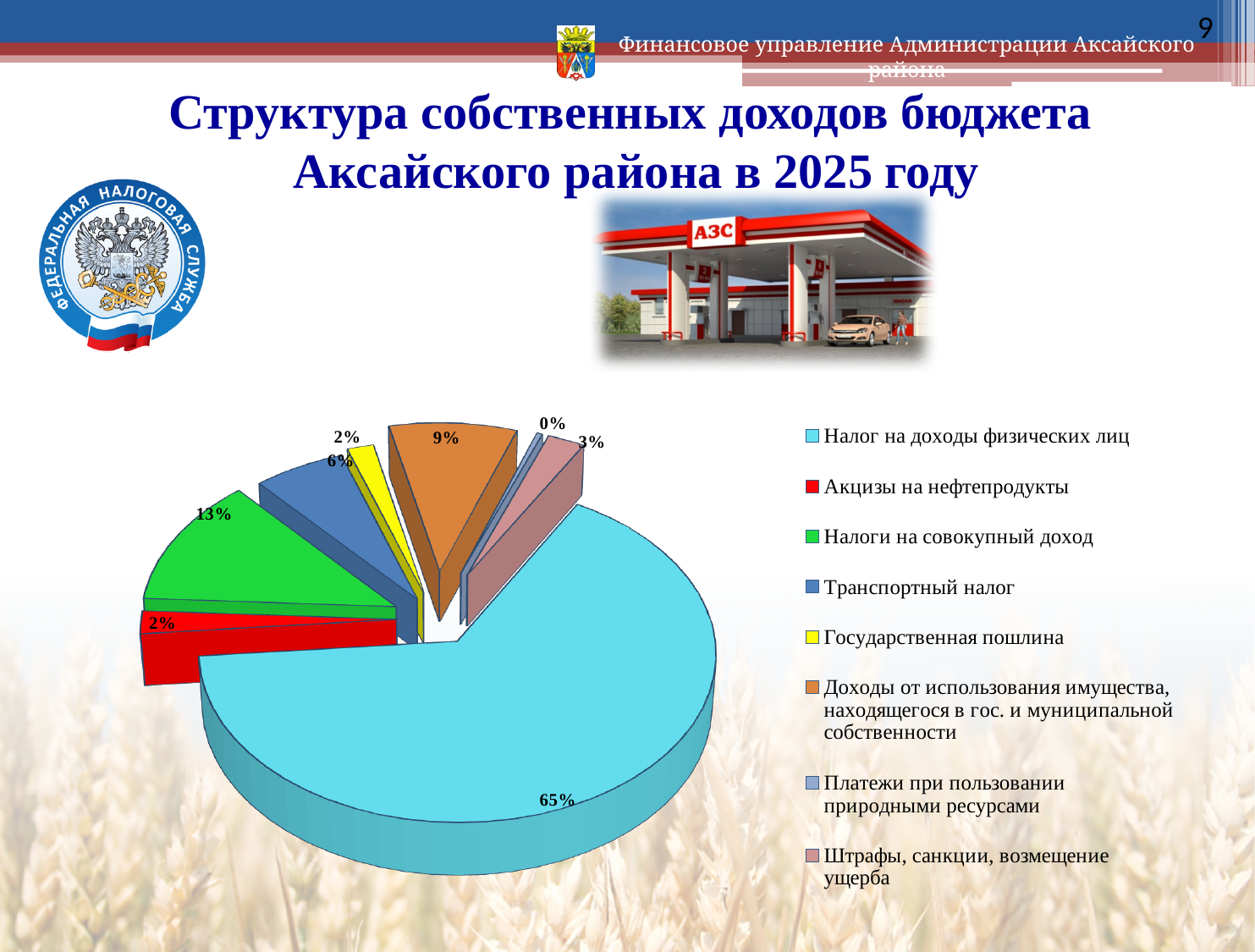
Which is larger: "Транспортный налог" or "Доходы от использования имущества, находящегося в гос. и муниципальной собственности"? Доходы от использования имущества, находящегося в гос. и муниципальной собственности Which category has the smallest share of the pie? Платежи при пользовании природными ресурсами What is the value shown for "Штрафы, санкции, возмещение ущерба"? 3% What is the value shown for "Транспортный налог"? 6% What is the value shown for "Доходы от использования имущества, находящегося в гос. и муниципальной собственности"? 9% What is the value shown for "Платежи при пользовании природными ресурсами"? 0% What kind of chart is shown on the slide? Pie chart What is the difference in percentage points between "Налог на доходы физических лиц" and "Налоги на совокупный доход"? 52 What share of the pie does "Налог на доходы физических лиц" have? 65% Which category has the largest share of the pie? Налог на доходы физических лиц How many categories does the legend of the pie chart list? 8 What is the value shown for "Налоги на совокупный доход"? 13%